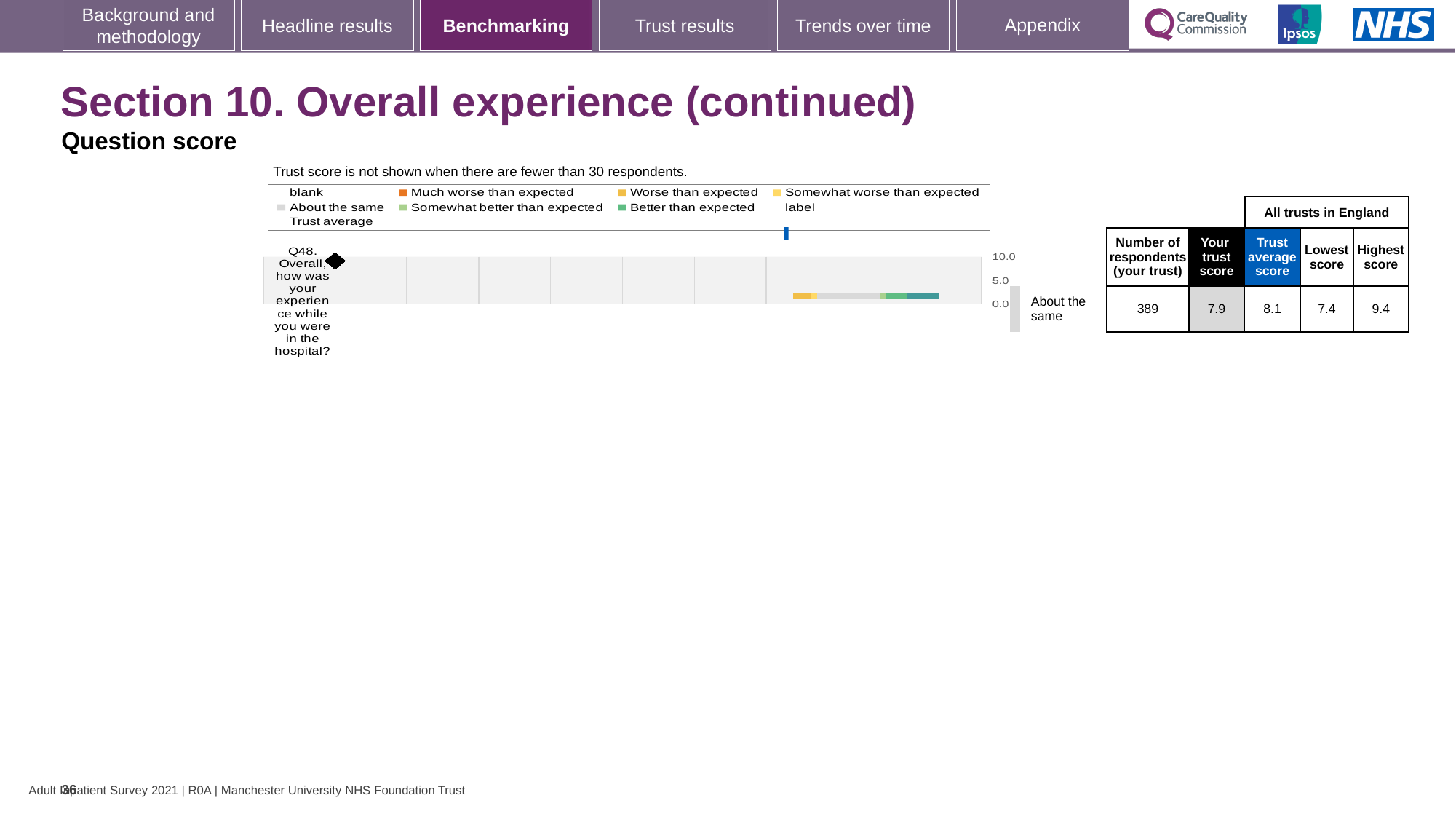
What is the lowest score among all trusts in England for Q48? 7.4 What is the highest score among all trusts in England for Q48? 9.4 Which is larger for Q48: the trust's own score or the trust average score? Trust average score What is the highest value shown on the chart's axis? 10.0 What is the trust score for Q48 shown in the table next to the chart? 7.9 What is the trust average score for Q48 across all trusts in England? 8.1 What benchmarking category label is shown to the right of the Q48 chart? About the same What kind of chart is used to show the Q48 benchmarking result? Bar chart How many respondents from the trust answered Q48? 389 How many questions are plotted in the benchmarking chart? 1 What is the difference between the trust average score and the trust's own score for Q48? 0.2 What is the difference between the highest score and the lowest score for Q48 across all trusts in England? 2.0